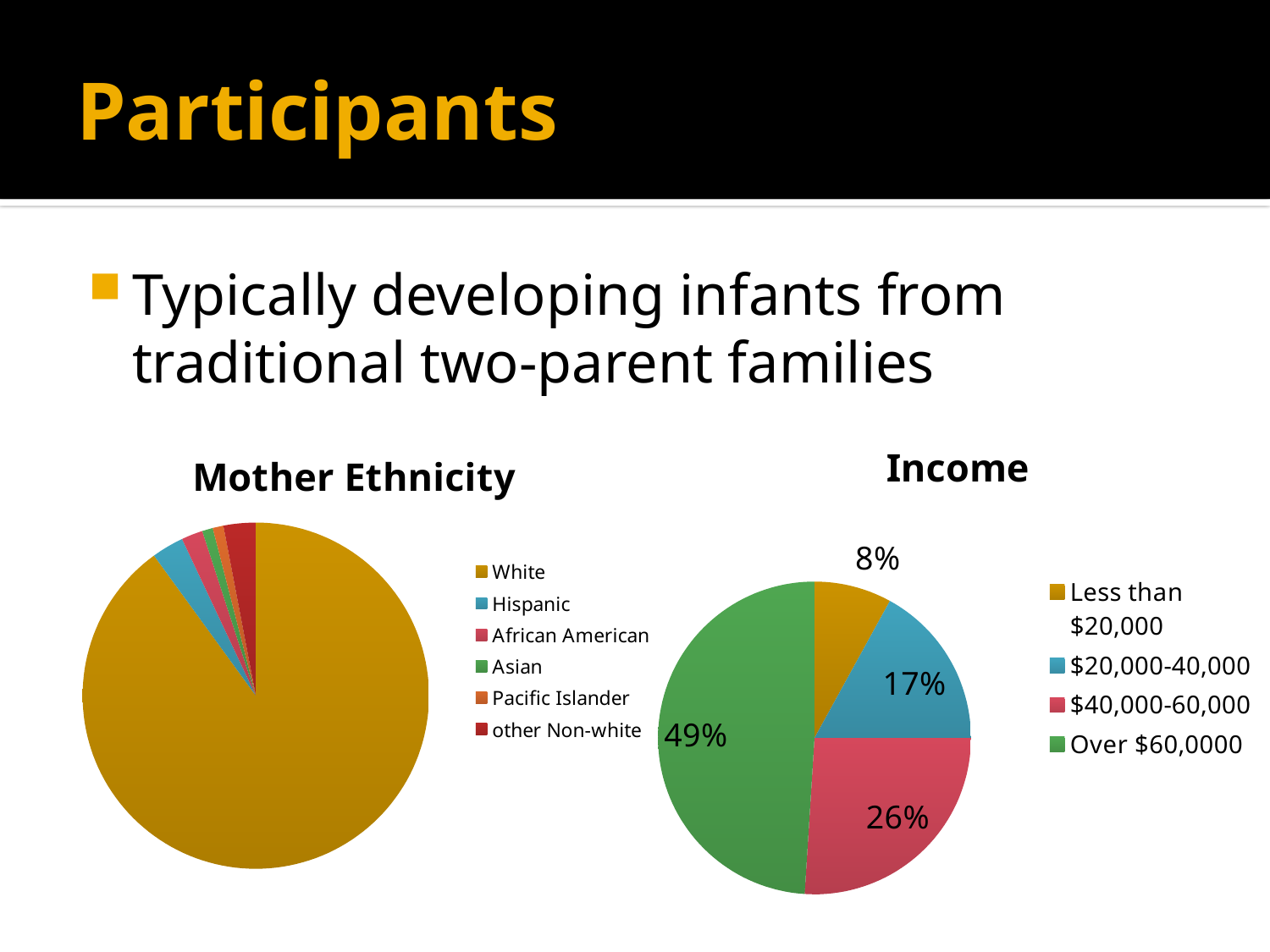
In the Income chart, what percentage of participants have an income of $20,000-40,000? 17% In the Income chart, which income category has the largest slice? Over $60,0000 In the Income chart, what percentage of participants have an income of less than $20,000? 8% In the Income chart, how many percentage points larger is the $20,000-40,000 slice than the Less than $20,000 slice? 9 percentage points In the Income chart, what percentage of participants have an income of $40,000-60,000? 26% How many income categories are shown in the Income chart? 4 In the Income chart, which is larger: the $20,000-40,000 slice or the $40,000-60,000 slice? $40,000-60,000 What kind of chart is the Mother Ethnicity chart? Pie chart In the Mother Ethnicity chart, which ethnicity has the largest slice? White In the Income chart, how many percentage points larger is the Over $60,0000 slice than the $40,000-60,000 slice? 23 percentage points In the Income chart, what share of the pie is taken by the Over $60,0000 category? 49% In the Income chart, which income category has the smallest slice? Less than $20,000